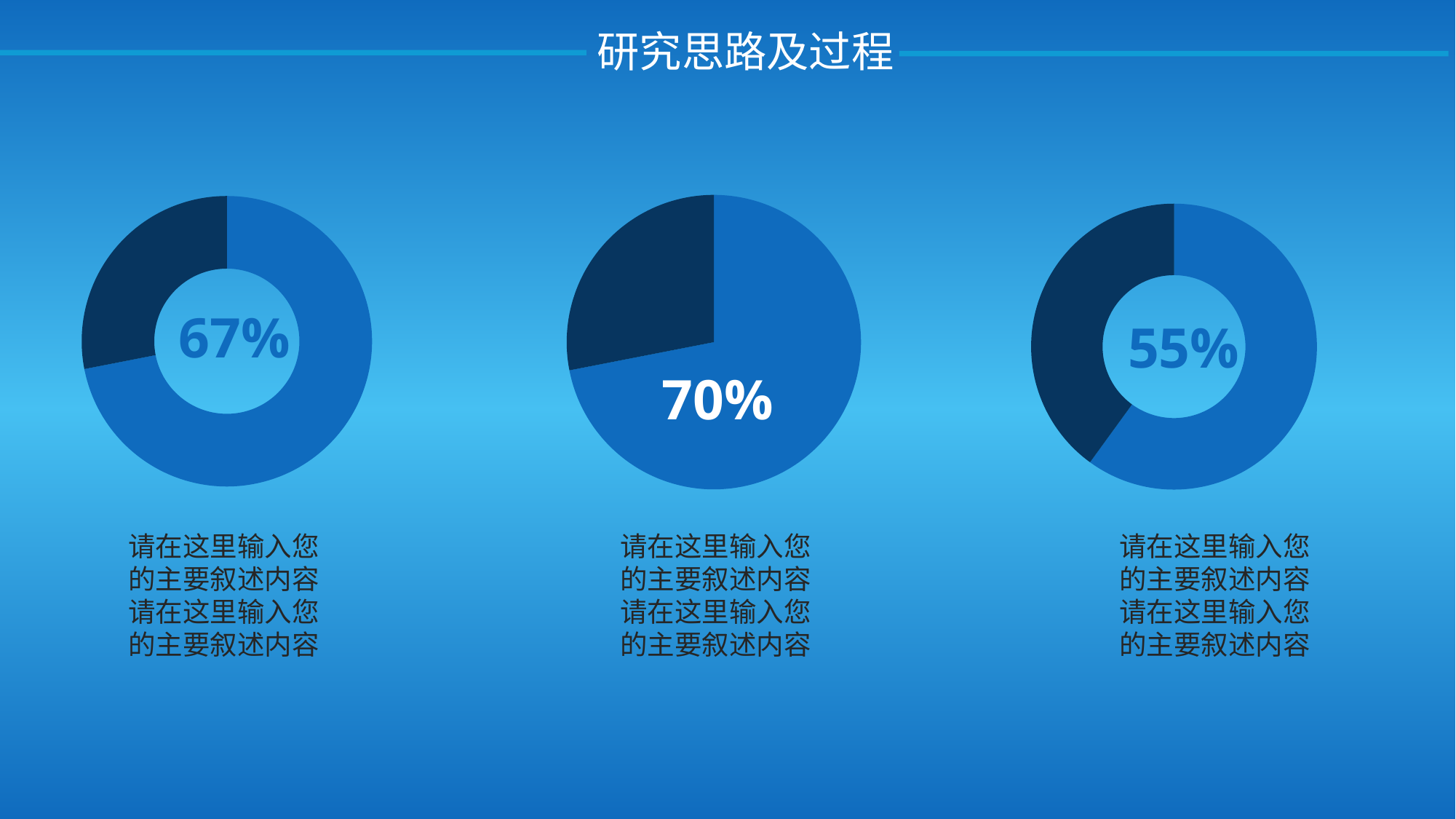
What kind of chart is the middle chart on the slide? pie chart How many charts are shown on the slide? 3 Is the percentage on the left chart larger or smaller than the percentage on the right chart? larger How many slices does the left doughnut chart have? 2 How many slices does the middle pie chart have? 2 What percentage is printed in the centre of the right doughnut chart? 55% What percentage is printed in the centre of the left doughnut chart? 67% Which of the three charts shows the lowest percentage? the right chart (55%) What is the difference between the percentage on the middle chart and the percentage on the right chart? 15% What percentage is printed on the middle pie chart? 70% Which of the three charts shows the highest percentage? the middle chart (70%) What kind of chart is the left chart on the slide? doughnut chart